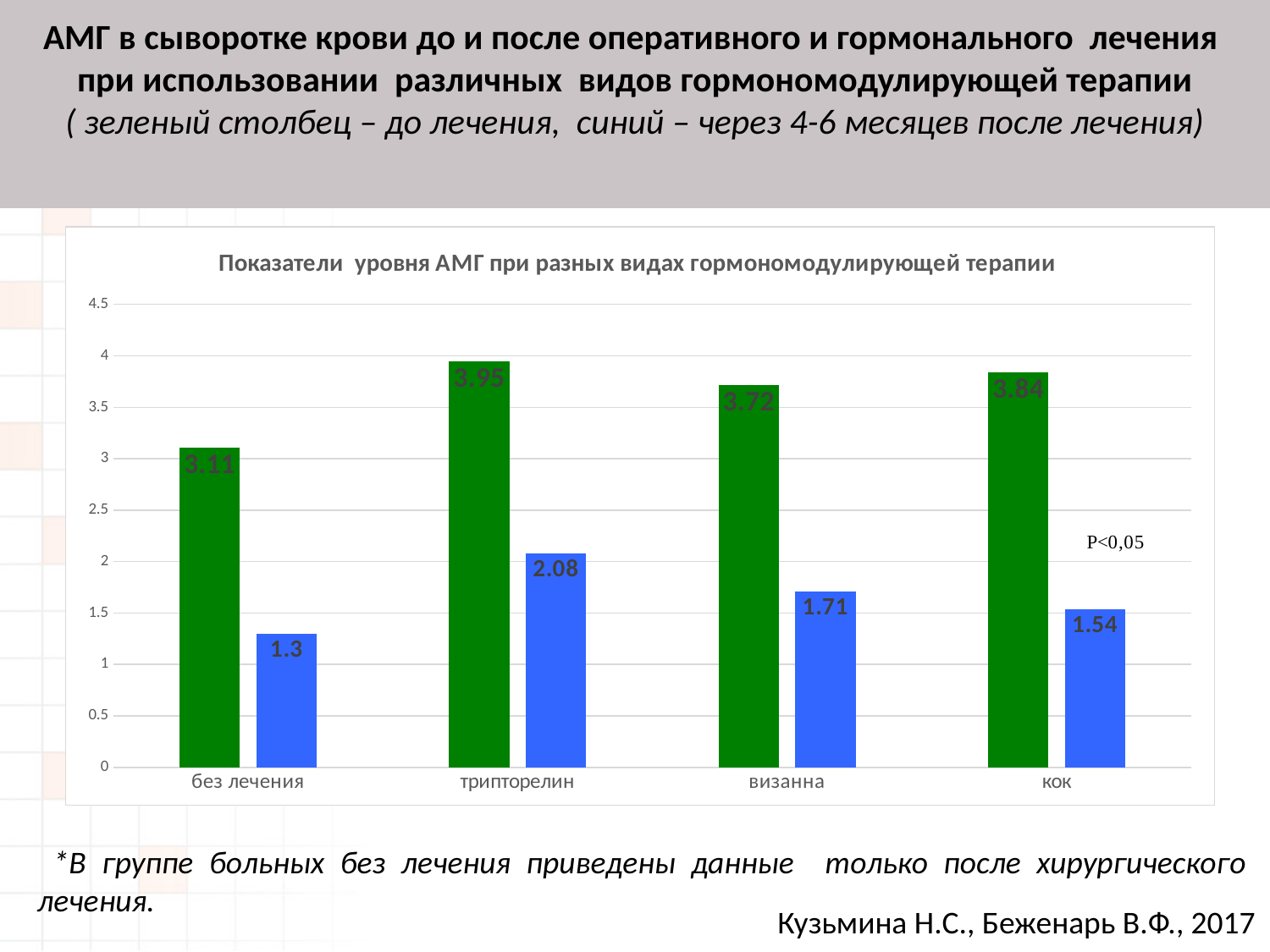
Is the green bar for без лечения greater or less than 3? greater What is the value of the blue bar (after treatment) for кок? 1.54 How many categories are shown on the x axis? 4 Which is larger: the blue bar for трипторелин or the blue bar for визанна? трипторелин What is the title of the chart? Показатели уровня АМГ при разных видах гормономодулирующей терапии What kind of chart is shown on the slide? bar chart Which category has the highest green (before treatment) bar? трипторелин What is the difference between the green bars for кок and без лечения? 0.73 Which category has the lowest blue (after treatment) bar? без лечения What is the value of the blue bar (after treatment) for без лечения? 1.3 What is the difference between the green and blue bars for визанна? 2.01 What is the value of the green bar (before treatment) for трипторелин? 3.95